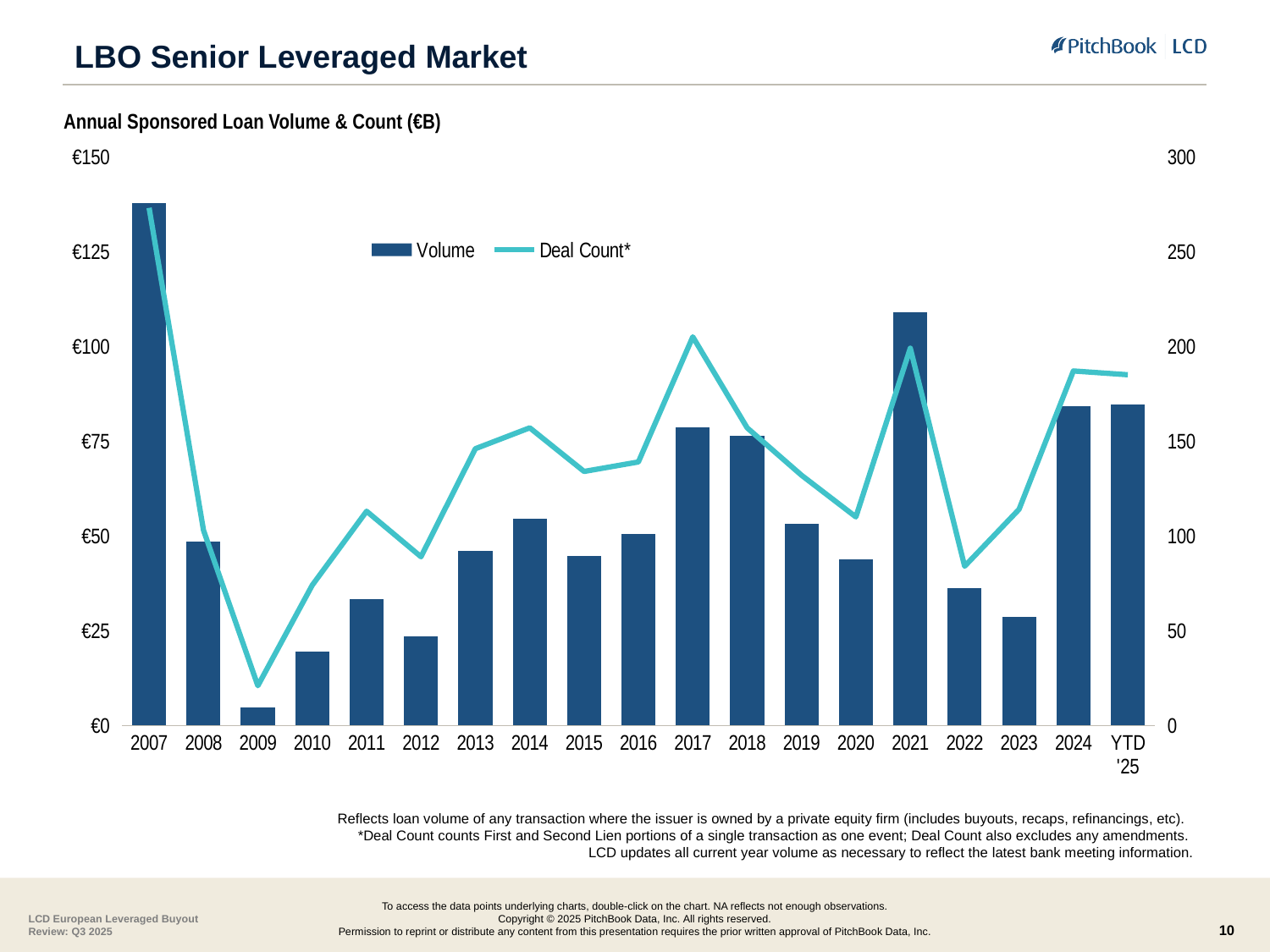
What are the two series named in the legend? Volume and Deal Count* Is the loan volume for 2010 greater or less than €25? less Which year has the lowest deal count? 2009 Is the loan volume for 2021 greater or less than €100? greater Which year has the larger loan volume, 2021 or 2024? 2021 Is the deal count for 2017 greater or less than 150? greater How many series does the legend list? 2 Does loan volume rise or fall from 2021 to 2023? fall What type of chart is shown on the slide? Combined bar and line chart Which year has the lowest loan volume? 2009 Which year has the highest loan volume? 2007 How many years (categories) are shown on the x axis? 19